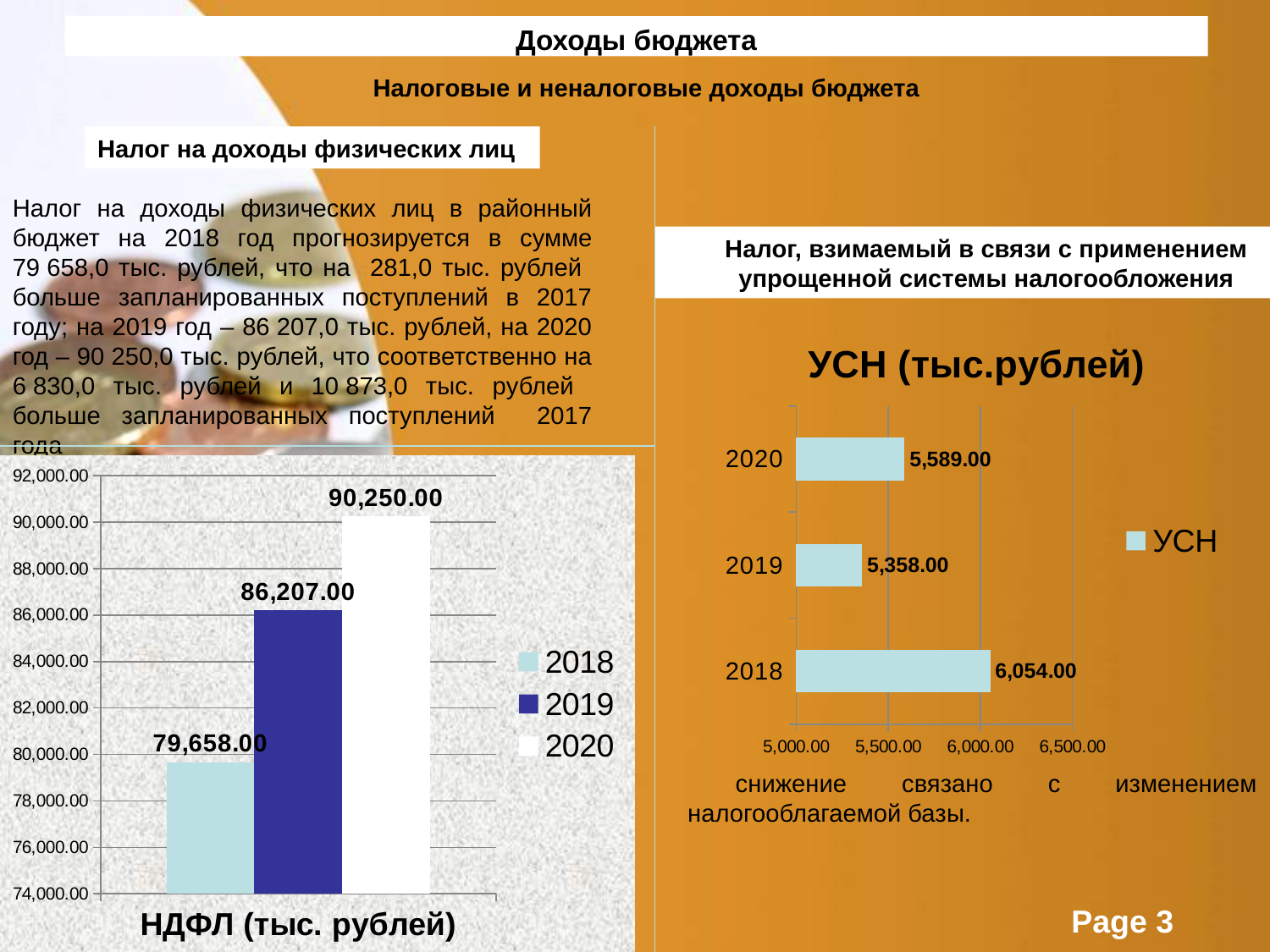
In the УСН (тыс.рублей) chart, what is the value for 2018? 6,054.00 In the НДФЛ (тыс. рублей) chart, which year has the highest value? 2020 In the НДФЛ (тыс. рублей) chart, what is the value for 2018? 79,658.00 In the НДФЛ (тыс. рублей) chart, what is the difference between the 2020 and 2019 values? 4,043.00 In the УСН (тыс.рублей) chart, what is the value for 2019? 5,358.00 In the НДФЛ (тыс. рублей) chart, what is the value for 2020? 90,250.00 In the УСН (тыс.рублей) chart, which is larger, the value for 2020 or the value for 2019? 2020 In the УСН (тыс.рублей) chart, which year has the lowest value? 2019 In the НДФЛ (тыс. рублей) chart, how many entries does the legend list? 3 What kind of chart is the УСН (тыс.рублей) chart? bar chart In the УСН (тыс.рублей) chart, what is the difference between the 2018 and 2020 values? 465.00 In the НДФЛ (тыс. рублей) chart, do the values rise or fall from 2018 to 2020? rise